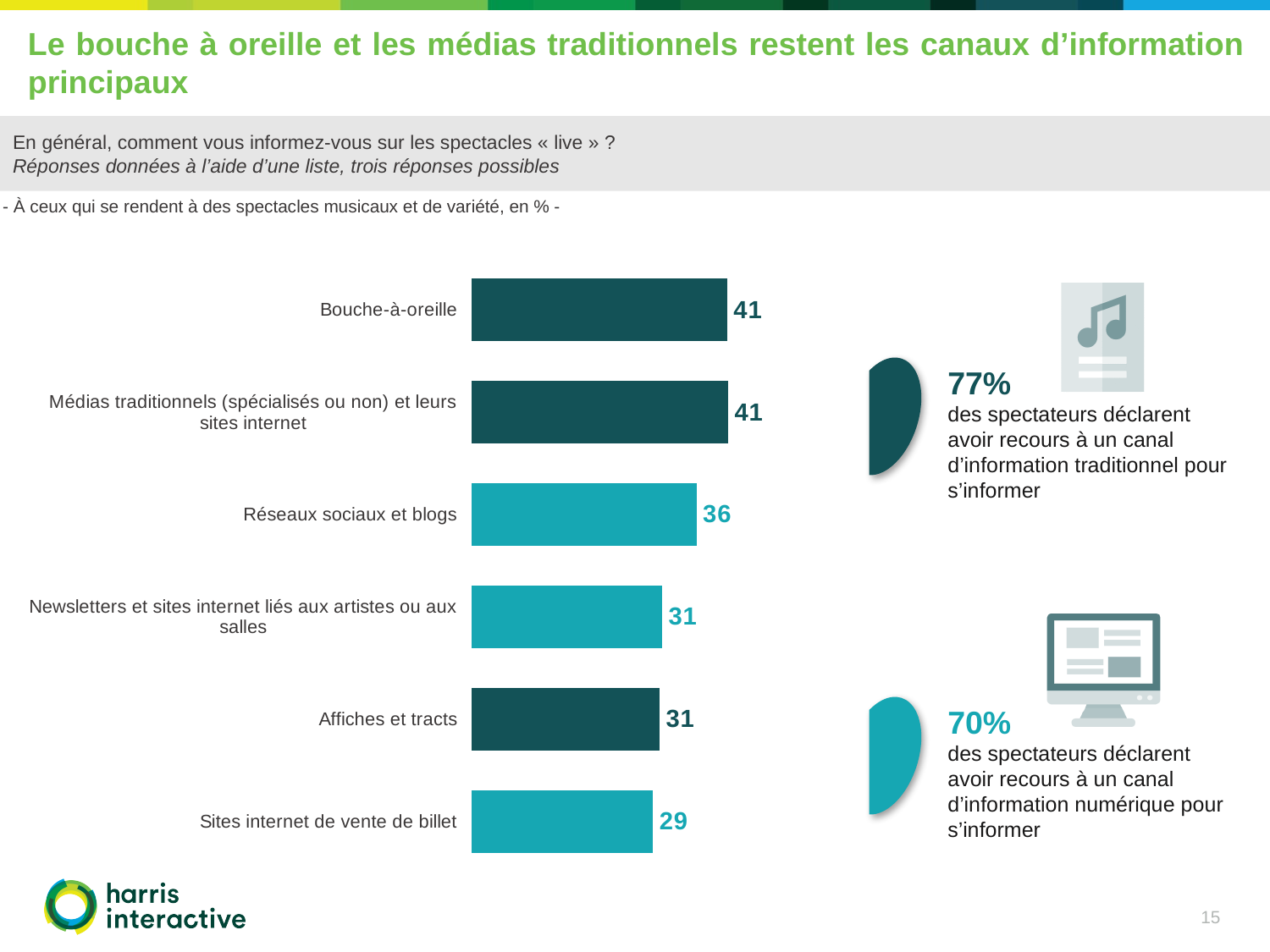
What percentage of spectators declare using a digital information channel, according to the callout on the right? 70% Which category has the lowest value? Sites internet de vente de billet What is the difference between the value for Réseaux sociaux et blogs and the value for Affiches et tracts? 5 What is the value for Affiches et tracts? 31 What is the value for Sites internet de vente de billet? 29 What is the difference between the value for Bouche-à-oreille and the value for Sites internet de vente de billet? 12 What is the value for Réseaux sociaux et blogs? 36 What is the value for Médias traditionnels (spécialisés ou non) et leurs sites internet? 41 Which is larger, the value for Réseaux sociaux et blogs or the value for Newsletters et sites internet liés aux artistes ou aux salles? Réseaux sociaux et blogs What kind of chart is shown on the slide? Bar chart What is the value for Bouche-à-oreille? 41 How many categories are shown in the chart? 6